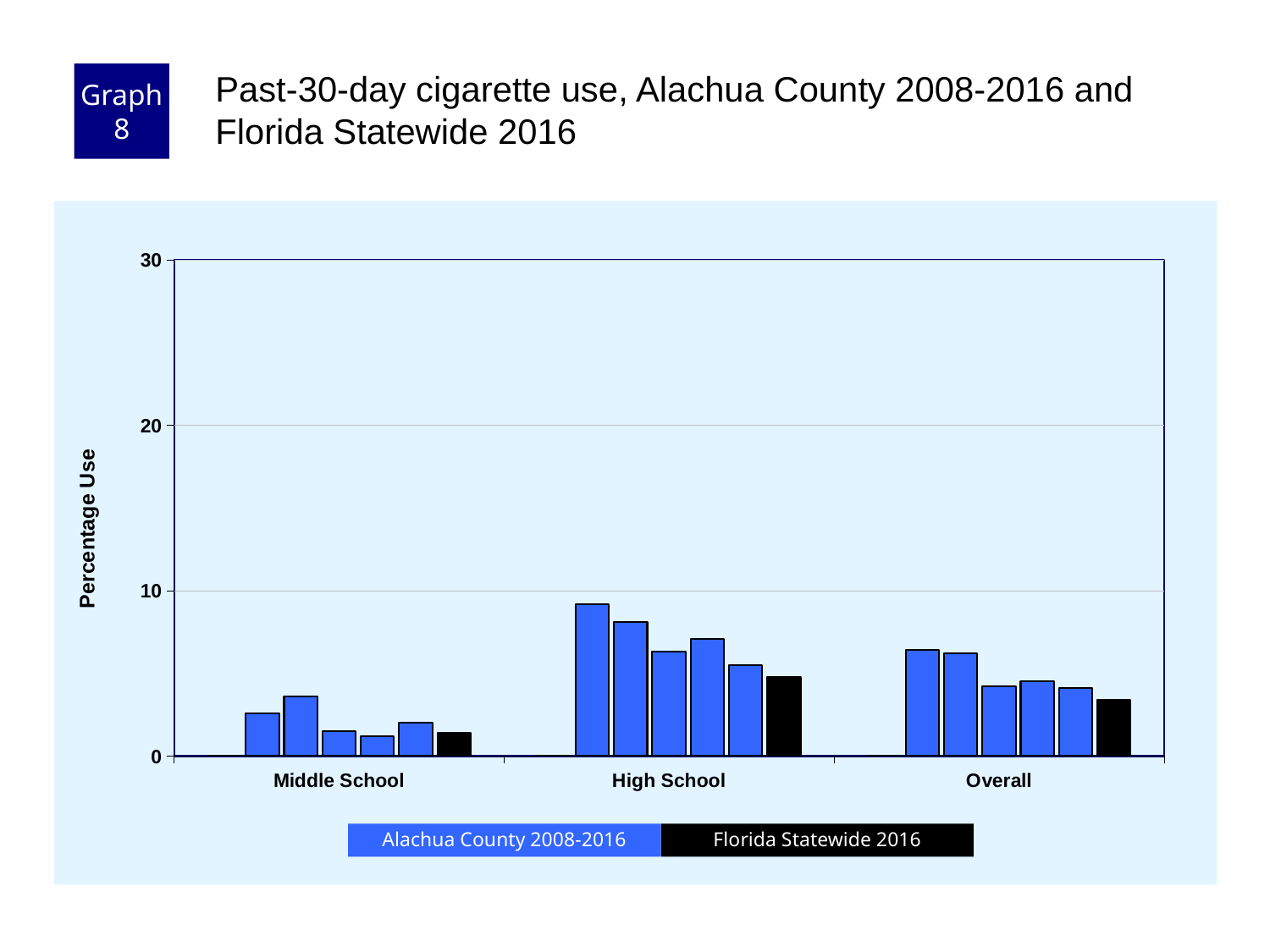
What is the label on the y axis? Percentage Use Which is larger, the Florida Statewide 2016 value for High School or for Middle School? High School Is the Florida Statewide 2016 value for Overall greater or less than 10? less Is the Florida Statewide 2016 value for High School greater or less than 10? less Which is larger, the Florida Statewide 2016 value for Overall or for Middle School? Overall Which category has the shortest bars? Middle School Which category has the tallest bars? High School What colour represents Florida Statewide 2016 in the legend? black What kind of chart is shown on the slide? bar chart How many categories are shown on the x axis? 3 Is the tallest Alachua County bar for High School greater or less than 10? less How many series does the legend list? 2